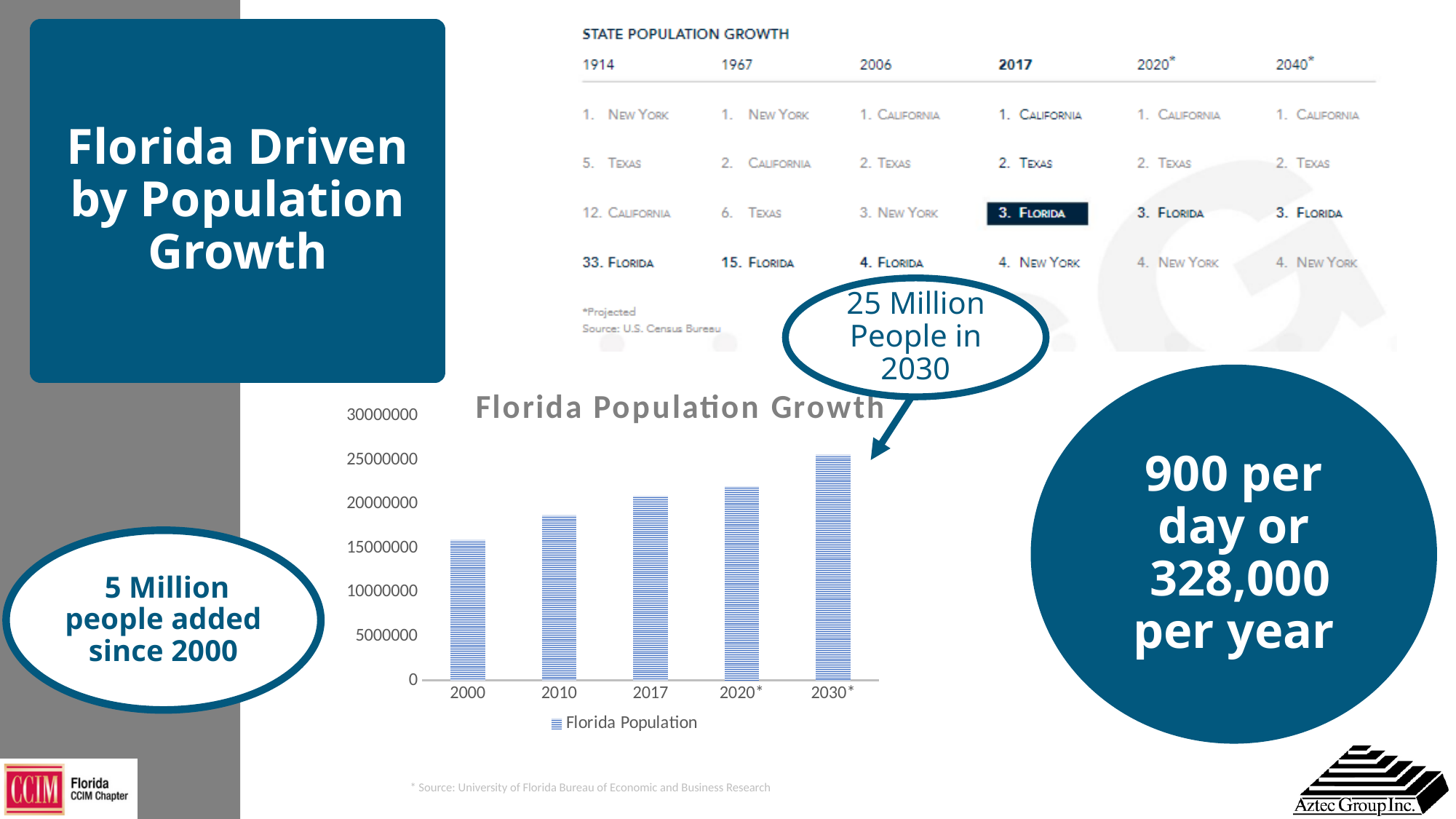
Which year has the lowest bar in the Florida Population Growth chart? 2000 In the Florida Population Growth chart, is the value for 2000 greater or less than 20000000? less What type of chart is shown on the slide? Bar chart In the Florida Population Growth chart, which is larger, the value for 2010 or the value for 2020*? 2020* What is the name of the series in the legend of the Florida Population Growth chart? Florida Population Do the values in the Florida Population Growth chart rise or fall from 2000 to 2030*? Rise In the Florida Population Growth chart, is the value for 2020* greater or less than 20000000? greater How many categories (years) are shown on the x axis of the Florida Population Growth chart? 5 What is the title of the chart on the slide? Florida Population Growth Which year has the highest bar in the Florida Population Growth chart? 2030* In the Florida Population Growth chart, is the value for 2010 greater or less than 20000000? less How many series does the legend of the Florida Population Growth chart list? 1